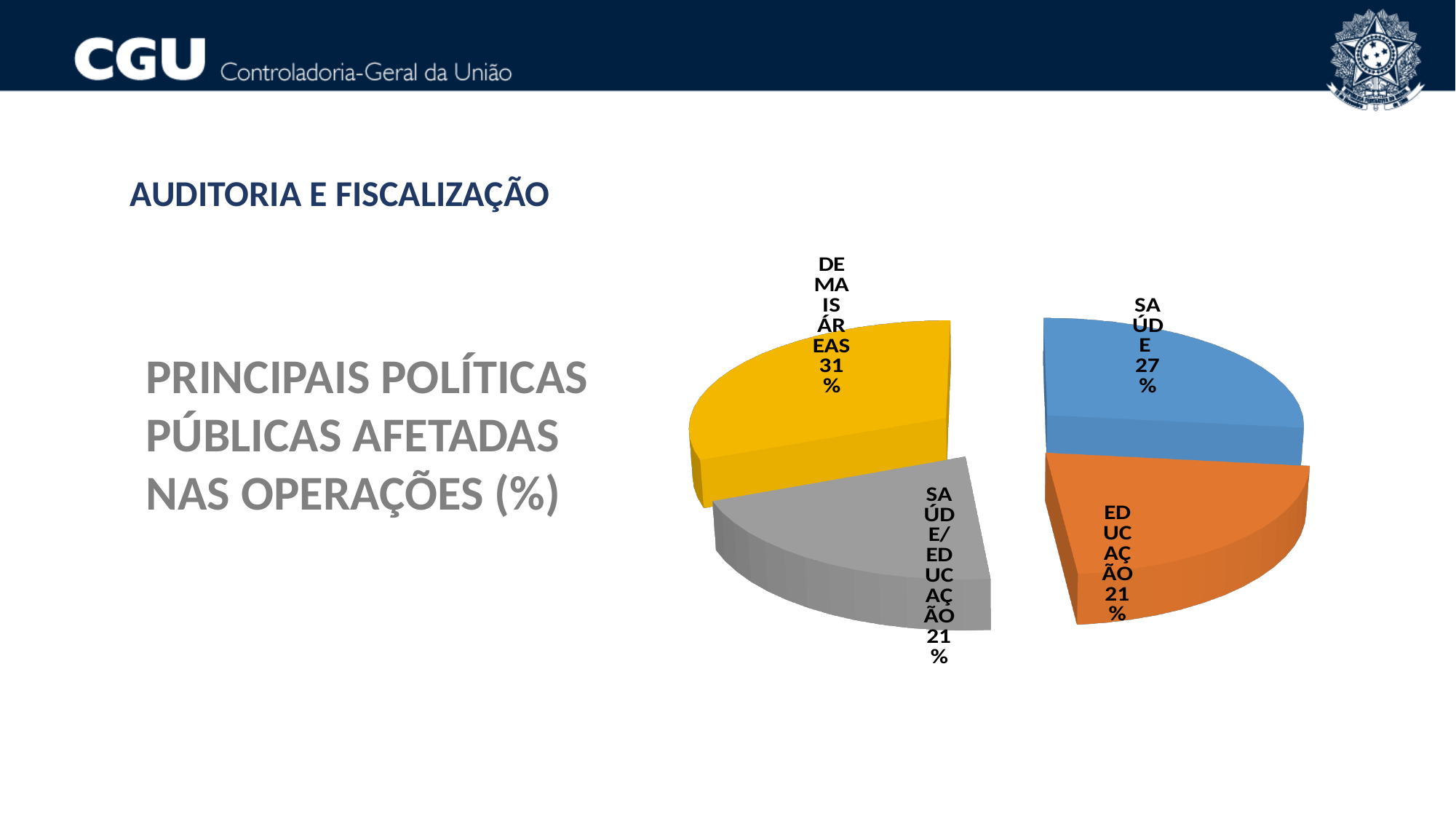
What is the difference in percentage points between SAÚDE and EDUCAÇÃO? 6 How many slices does the pie chart have? 4 What percentage does the DEMAIS ÁREAS slice represent? 31% What is the difference in percentage points between DEMAIS ÁREAS and SAÚDE? 4 What percentage does the SAÚDE/EDUCAÇÃO slice represent? 21% What colour is the DEMAIS ÁREAS slice? Yellow Which is larger, the SAÚDE slice or the EDUCAÇÃO slice? SAÚDE What percentage does the EDUCAÇÃO slice represent? 21% What colour is the SAÚDE slice? Blue What percentage does the SAÚDE slice represent? 27% Which slice of the pie chart is the largest? DEMAIS ÁREAS What type of chart is shown on the slide? Pie chart